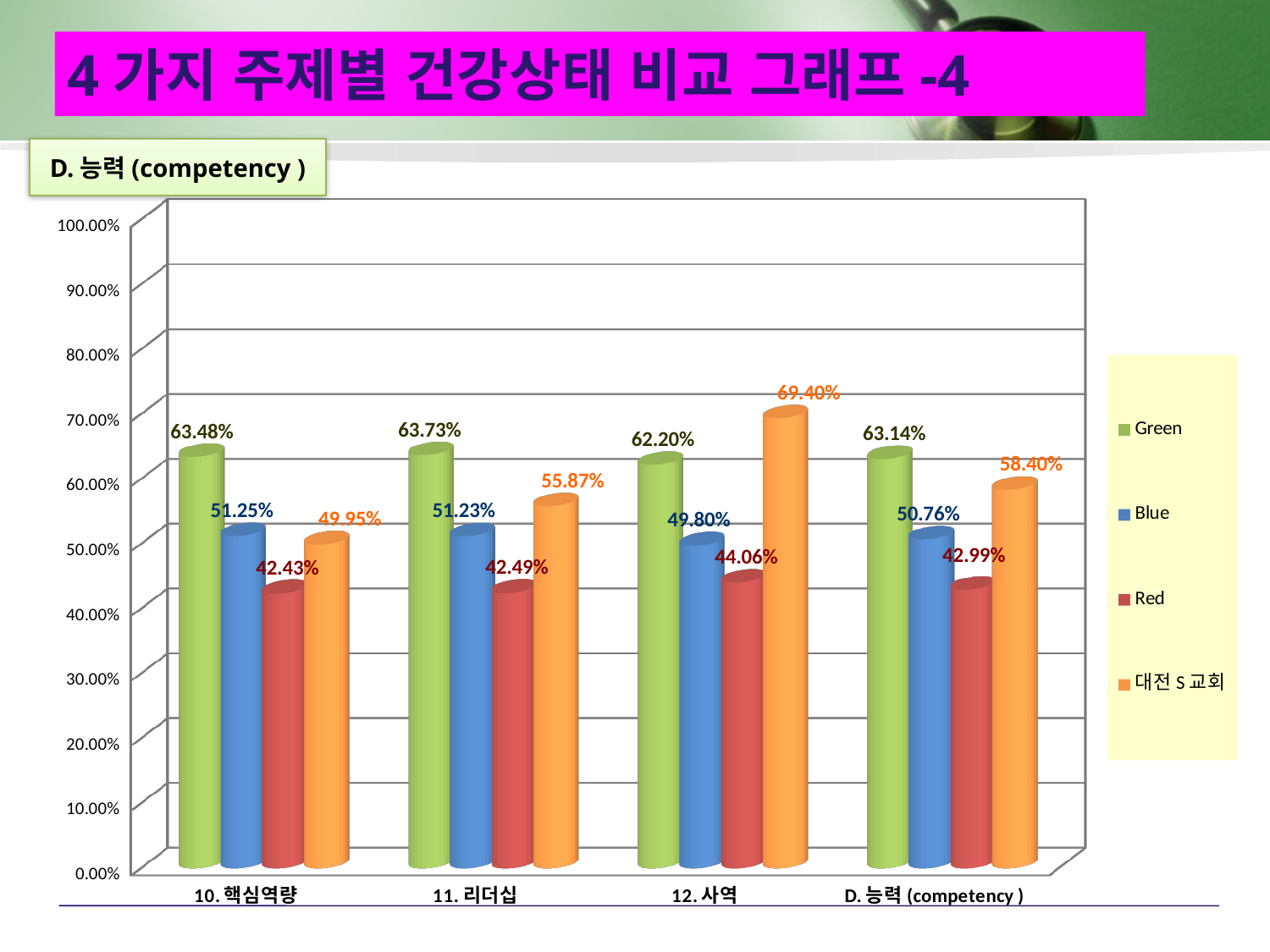
How many series does the legend list? 4 What is the difference between the Green and Red values for 11. 리더십? 21.24% What kind of chart is shown on the slide? Bar chart What is the value of the Red series for 10. 핵심역량? 42.43% For which category is the Red series lowest? 10. 핵심역량 For 12. 사역, which is larger: the Green value or the 대전 S 교회 value? 대전 S 교회 For which category is the 대전 S 교회 series highest? 12. 사역 What is the last entry in the chart legend? 대전 S 교회 What is the value of the Green series for 12. 사역? 62.20% How many categories are shown on the x axis? 4 What is the value of the 대전 S 교회 series for 11. 리더십? 55.87% What is the value of the Blue series for D. 능력 (competency )? 50.76%